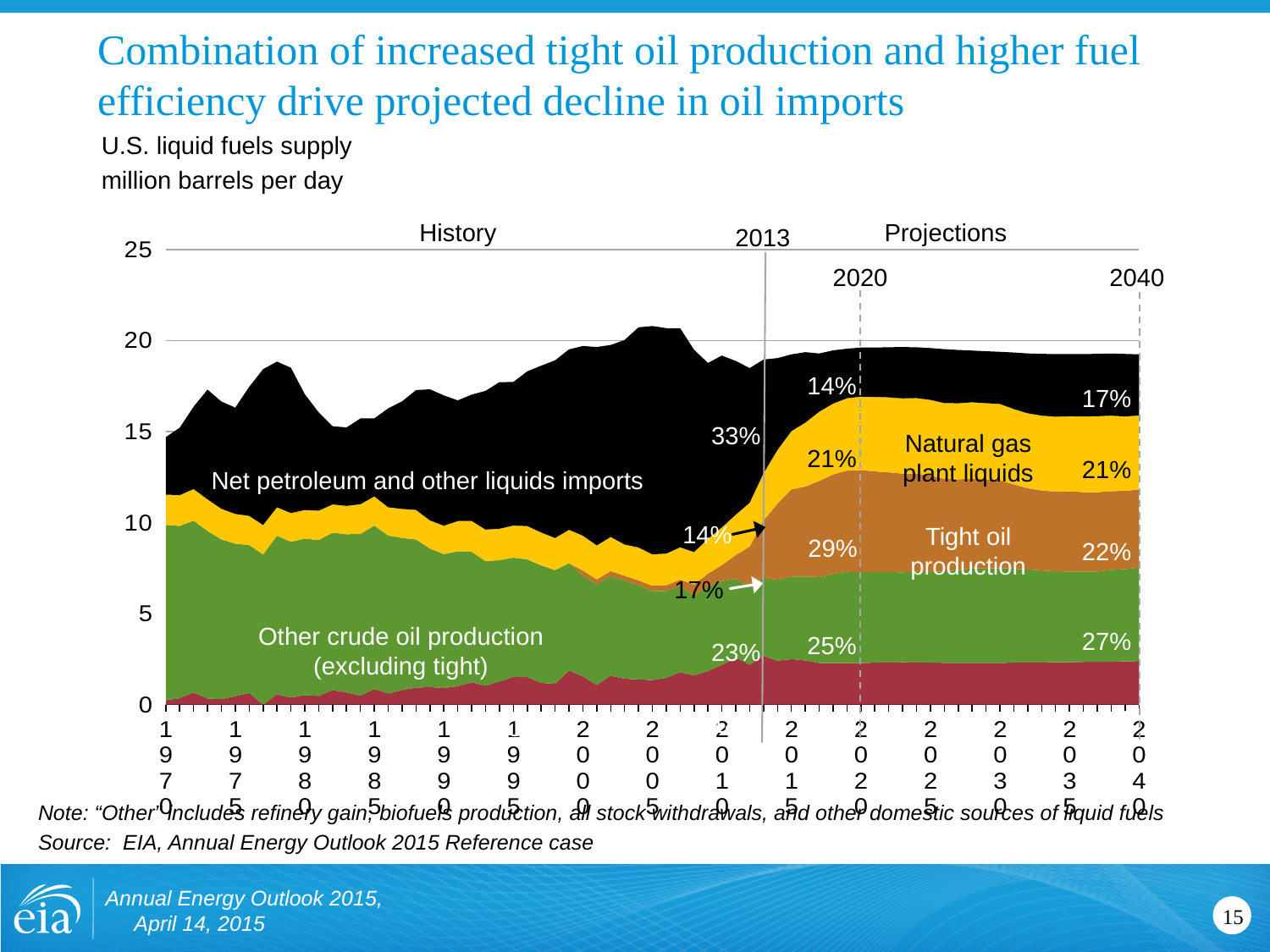
What kind of chart is shown on the slide? Stacked area chart Does the share of tight oil production rise or fall between 2020 and 2040? Fall What share of U.S. liquid fuels supply does natural gas plant liquids account for in 2040? 21% What share of U.S. liquid fuels supply do net petroleum and other liquids imports account for in 2040? 17% What unit is used on the chart's vertical axis? million barrels per day In 2020, which has the larger share of supply: tight oil production or natural gas plant liquids? Tight oil production What share of U.S. liquid fuels supply do net petroleum and other liquids imports account for in 2013? 33% By how many percentage points does the share of net petroleum and other liquids imports fall between 2013 and 2020? 19 percentage points What share of U.S. liquid fuels supply do net petroleum and other liquids imports account for in 2020? 14% What share of U.S. liquid fuels supply does tight oil production account for in 2020? 29% What share of U.S. liquid fuels supply does other crude oil production (excluding tight) account for in 2040? 27% Is total U.S. liquid fuels supply in 2040 greater or less than 15 million barrels per day? greater